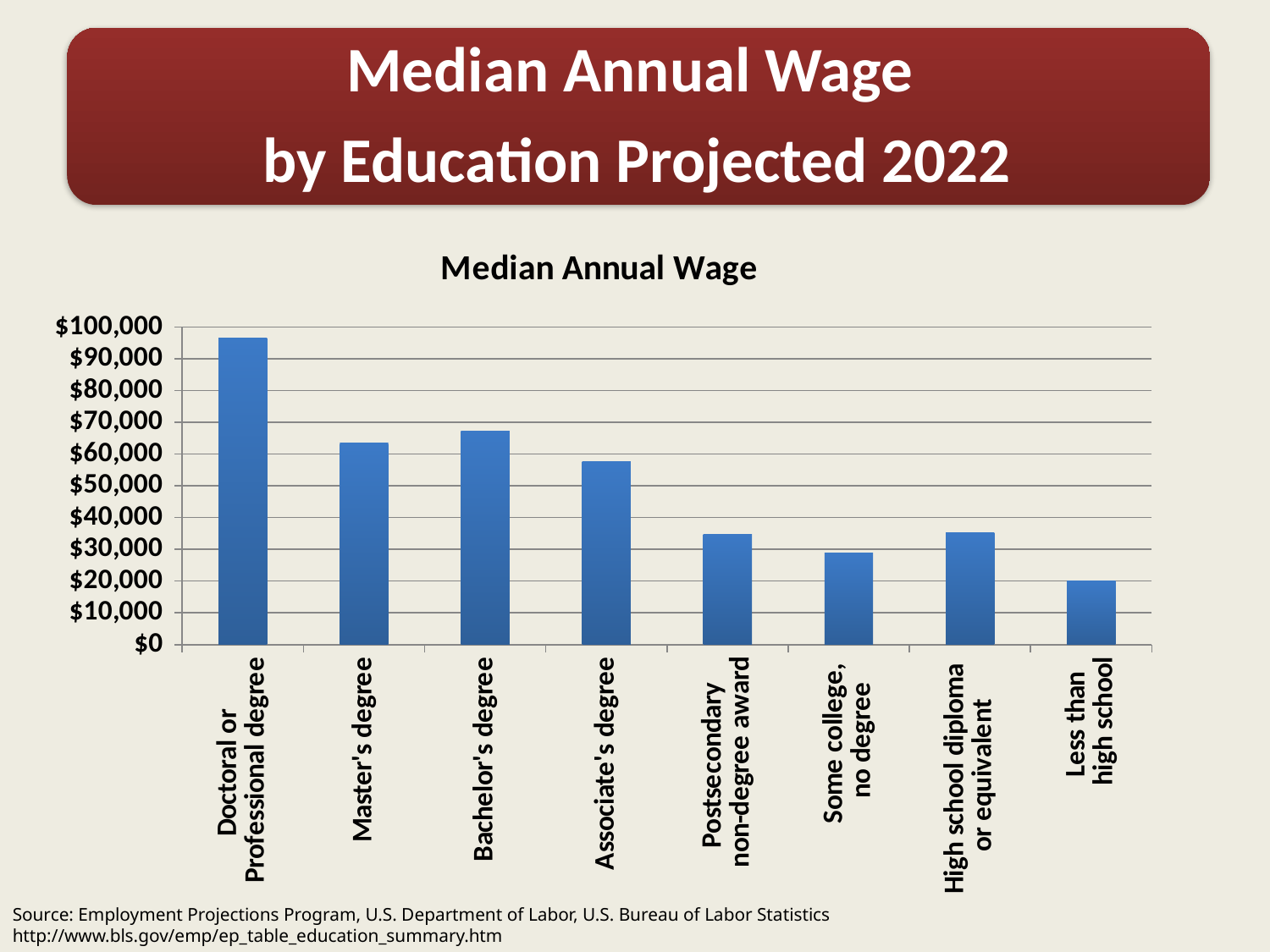
Is the value for Postsecondary non-degree award greater or less than $40,000? less How many education categories are plotted on the chart? 8 Which has a higher median annual wage, Bachelor's degree or Master's degree? Bachelor's degree Is the value for Doctoral or Professional degree greater or less than $90,000? greater What is the title shown above the chart? Median Annual Wage What kind of chart is shown on the slide? bar chart Is the value for Associate's degree greater or less than $50,000? greater Which education category has the highest median annual wage? Doctoral or Professional degree Which education category has the lowest median annual wage? Less than high school